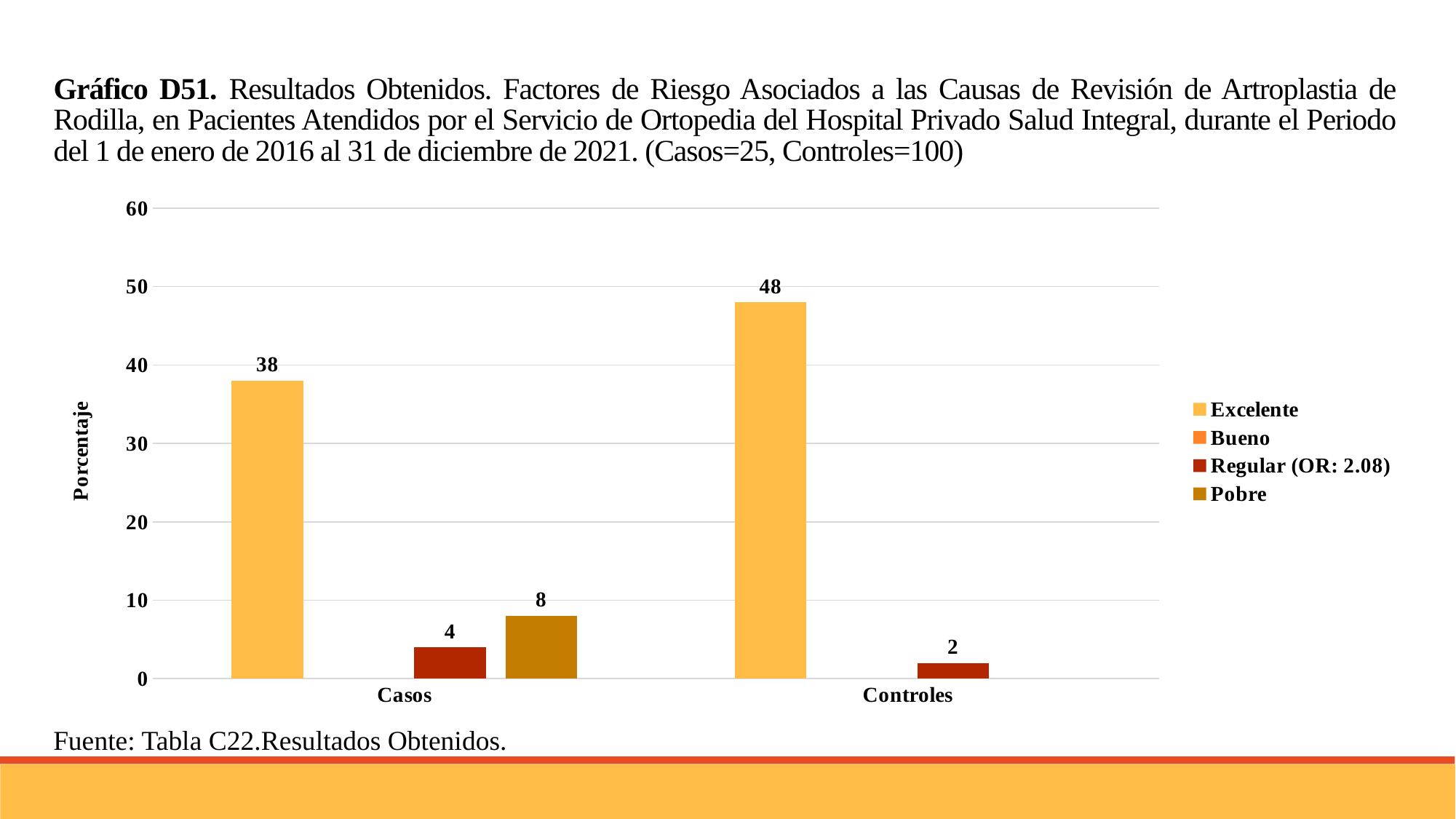
What is the label of the vertical axis? Porcentaje How many series does the legend list? 4 What is the value for Pobre in the Casos category? 8 What is the value for Regular (OR: 2.08) in the Controles category? 2 How many categories are shown on the x axis? 2 What is the difference between the Regular (OR: 2.08) values for Casos and Controles? 2 What kind of chart is shown on the slide? Bar chart What is the value for Excelente in the Controles category? 48 What is the difference between the Excelente values for Controles and Casos? 10 What is the value for Regular (OR: 2.08) in the Casos category? 4 Which category has the higher value for Excelente, Casos or Controles? Controles What is the value for Excelente in the Casos category? 38